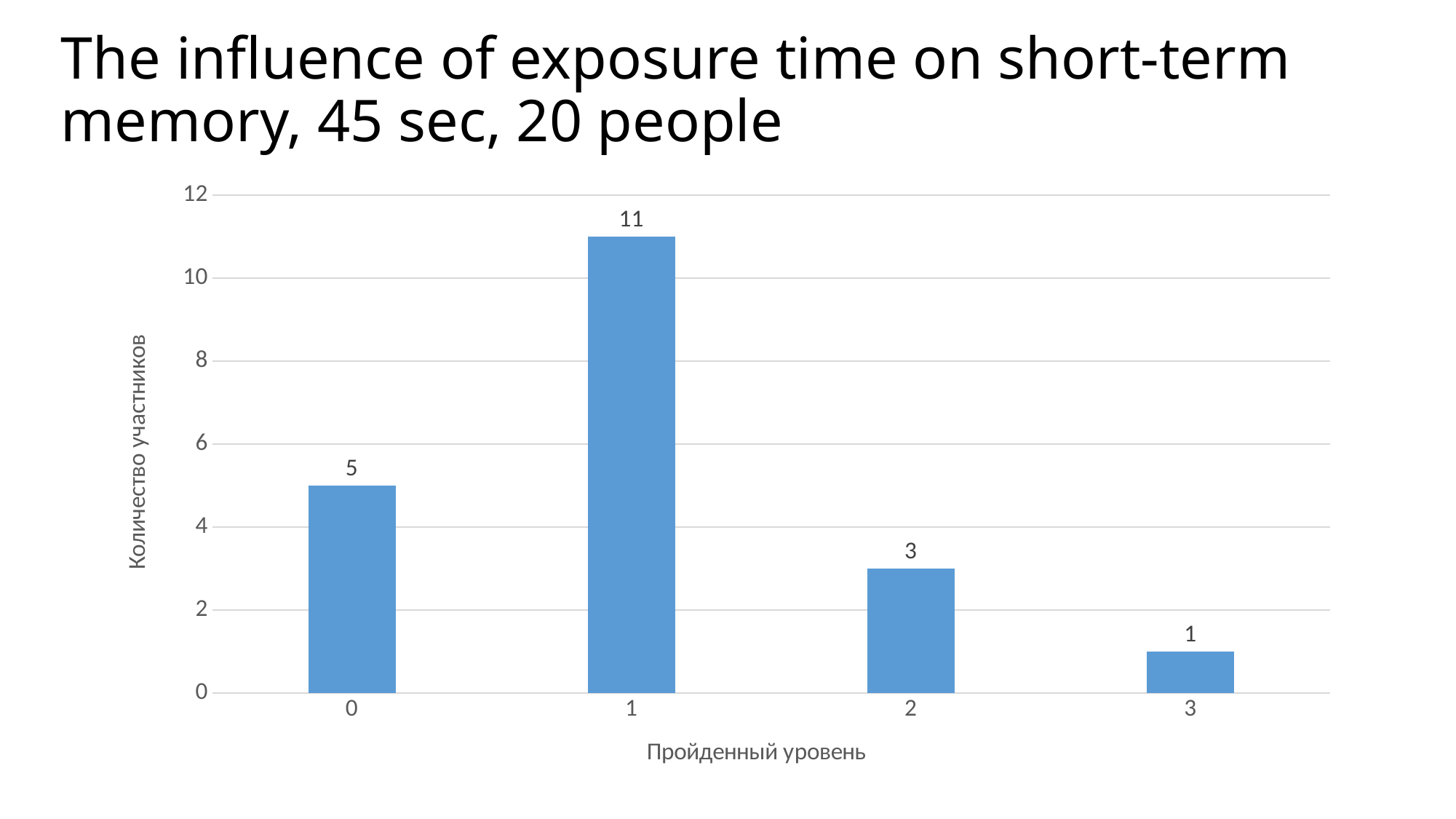
Which level has the lowest number of participants? 3 How many participants passed level 3? 1 What is the value for level 0? 5 What is the label of the x axis? Пройденный уровень What kind of chart is shown on the slide? bar chart How many participants passed level 1? 11 Which is larger, the value for level 0 or the value for level 2? level 0 What is the difference between the values for level 2 and level 3? 2 Is the value for level 1 greater or less than 10? greater What is the difference between the values for level 1 and level 0? 6 How many levels (categories) are shown on the x axis? 4 Which level has the highest number of participants? 1